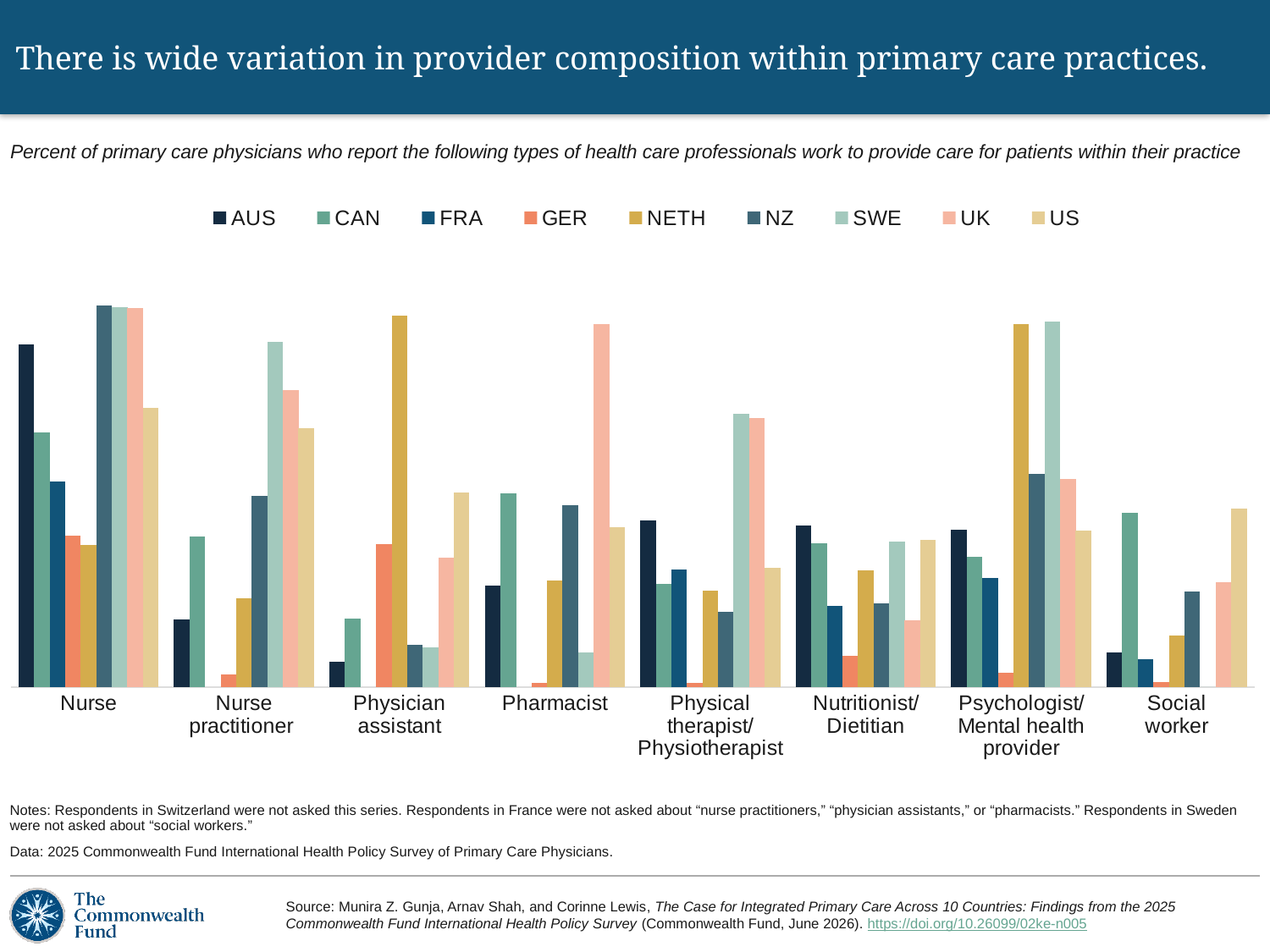
Which country has the lowest value for Pharmacist? GER Which country has the lowest value for Psychologist/Mental health provider? GER How many countries does the legend list? 9 For Nurse, which is larger, the value for AUS or the value for CAN? AUS For Physician assistant, which is larger, the value for NETH or the value for GER? NETH For Social worker, which is larger, the value for CAN or the value for AUS? CAN Which country has the highest value for Pharmacist? UK What kind of chart is shown on the slide? bar chart What is the title of the slide? There is wide variation in provider composition within primary care practices. Which country has the highest value for Physician assistant? NETH Which country has the highest value for Nurse practitioner? SWE How many types of health care professionals are shown along the x axis? 8